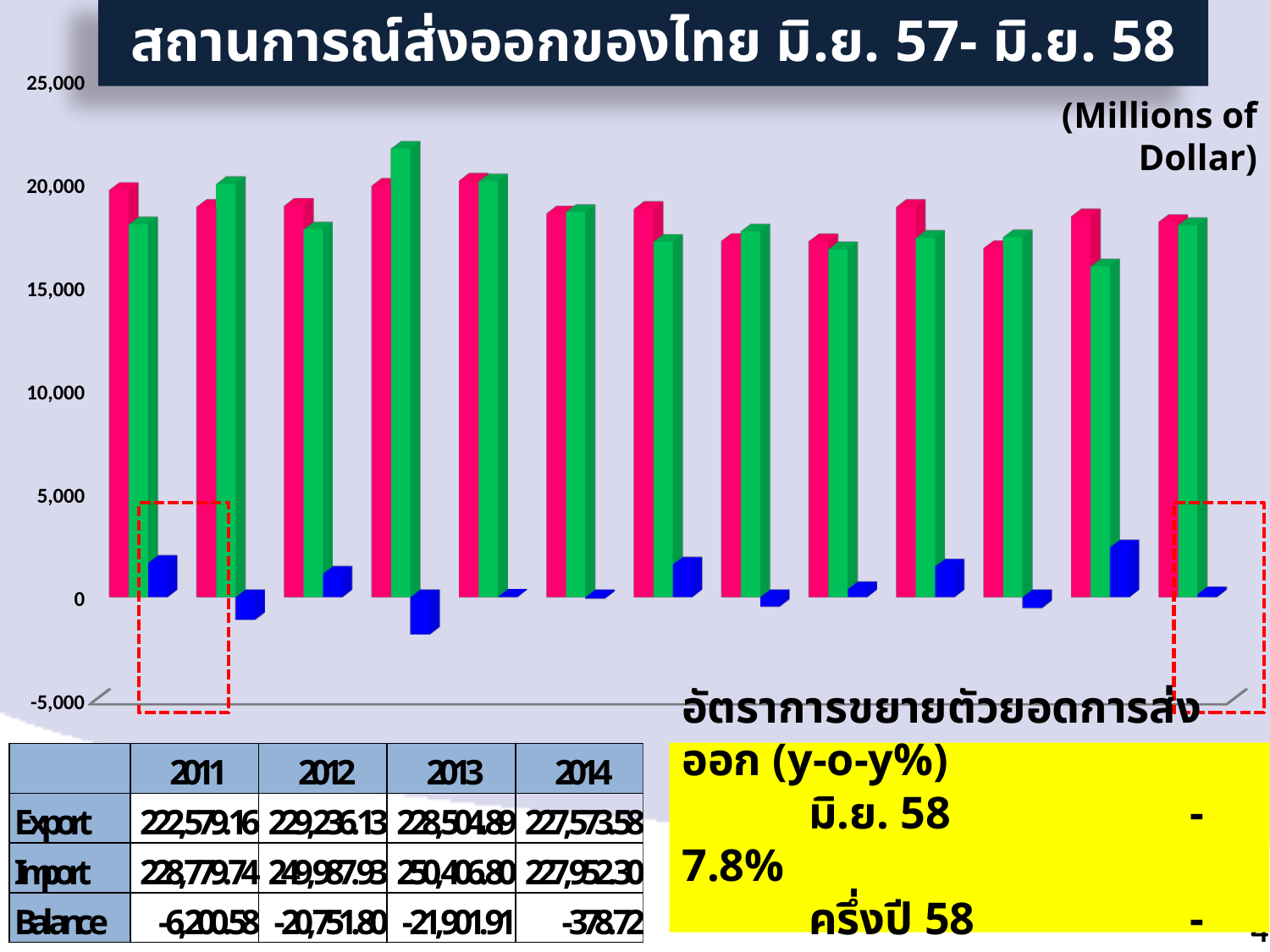
In the table below the chart, which year has the larger Export value, 2011 or 2012? 2012 What unit is stated for the values in the chart? Millions of Dollar Is the value of the tallest green bar in the chart greater or less than 20,000? greater What kind of chart is shown on the slide? bar chart Is the value of the shortest green bar in the chart greater or less than 15,000? greater What is the highest value shown on the chart's y axis? 25,000 How many groups of bars are plotted along the x axis of the chart? 13 In the table below the chart, what is the Balance value for 2014? -378.72 In the table below the chart, which year has the highest Import value? 2013 In the table below the chart, what is the Export value for 2012? 229,236.13 Is the value of the tallest blue bar in the chart greater or less than 5,000? less How many differently coloured bar series does the chart plot? 3